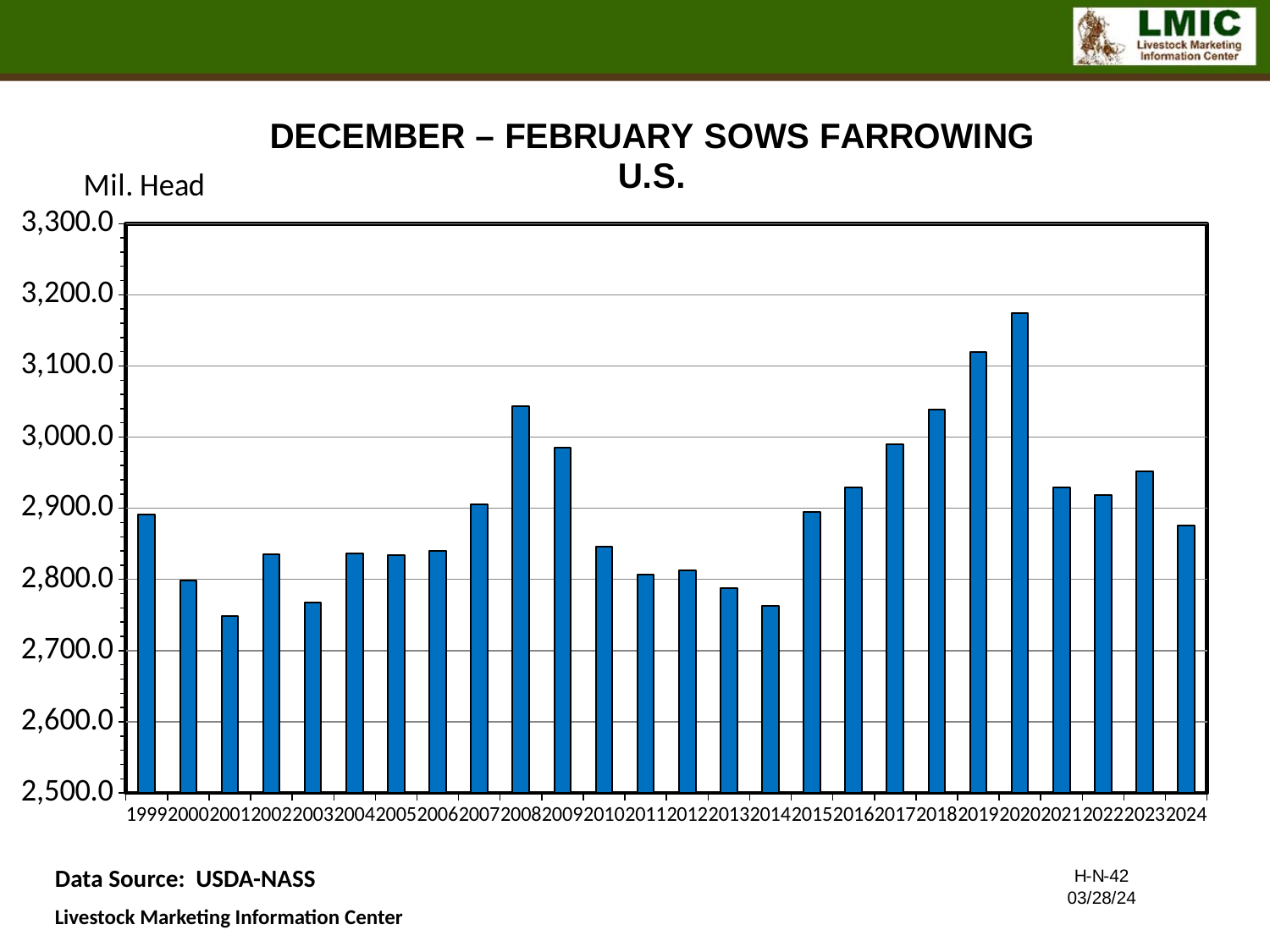
Which is larger, the value for 1999 or the value for 2000? 1999 Which is larger, the value for 2008 or the value for 2009? 2008 Is the value for 2008 greater or less than 3,000.0? greater Is the value for 2024 greater or less than 2,900.0? less Is the value for 2020 greater or less than 3,100.0? greater What unit is shown for the vertical axis of the chart? Mil. Head What kind of chart is shown on the slide? bar chart How many years (bars) are plotted on the chart? 26 Which year has the highest value for December–February sows farrowing? 2020 From 2014 to 2020, do the values rise or fall? rise